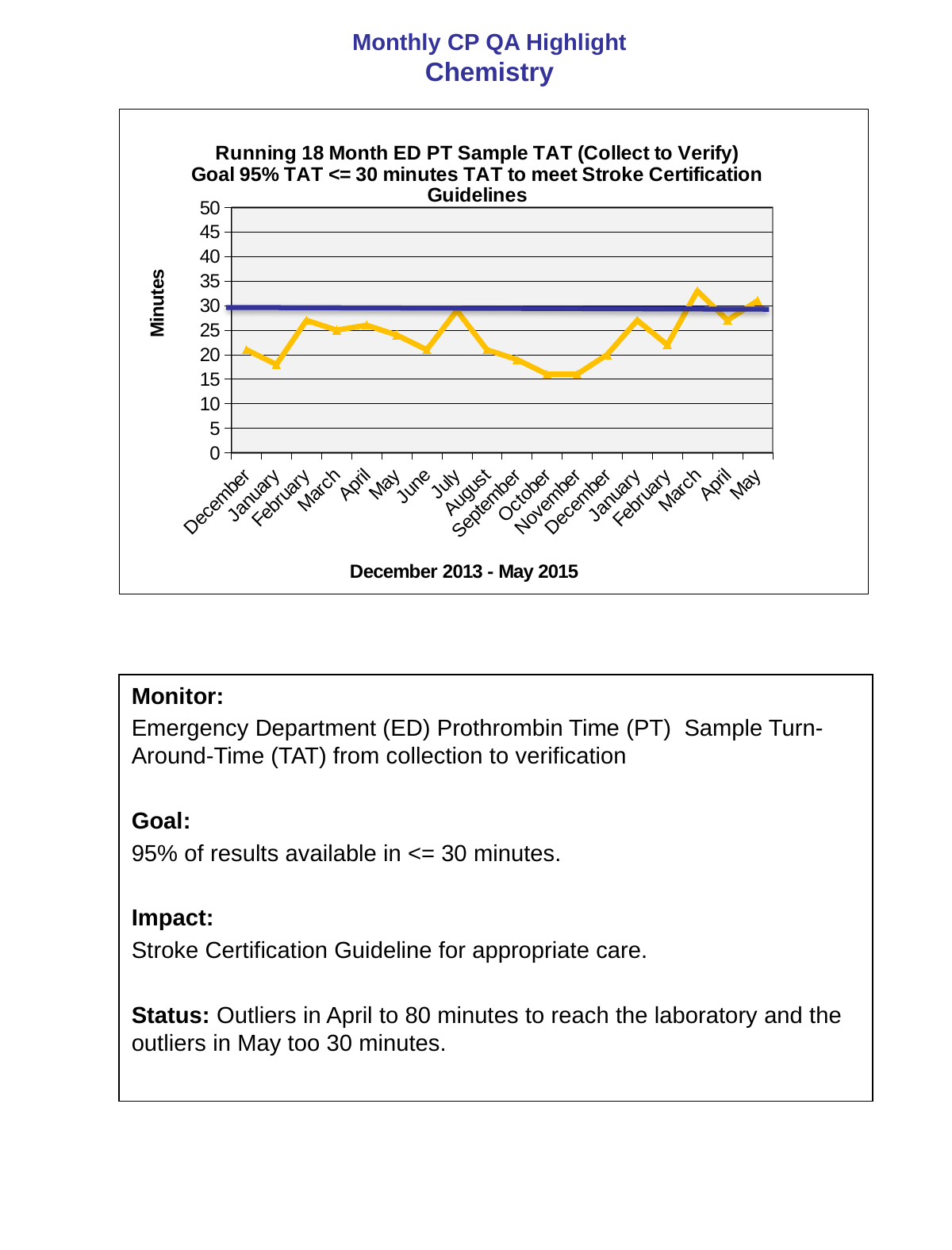
Is the value for January 2014 greater or less than 20 minutes? less What kind of chart is shown on the slide? line chart How many monthly data points are plotted on the chart? 18 Which month has the highest ED PT sample TAT on the chart? March (2015) Is the value for March 2015 greater or less than 30 minutes? greater Which is larger, the TAT for February 2014 or the TAT for January 2014? February 2014 What period does the horizontal axis label say the chart covers? December 2013 - May 2015 Do the values rise or fall from November 2014 to March 2015? rise Is the value for October 2014 greater or less than 20 minutes? less What is the label on the vertical axis of the chart? Minutes Which is larger, the TAT for March 2015 or the TAT for October 2014? March 2015